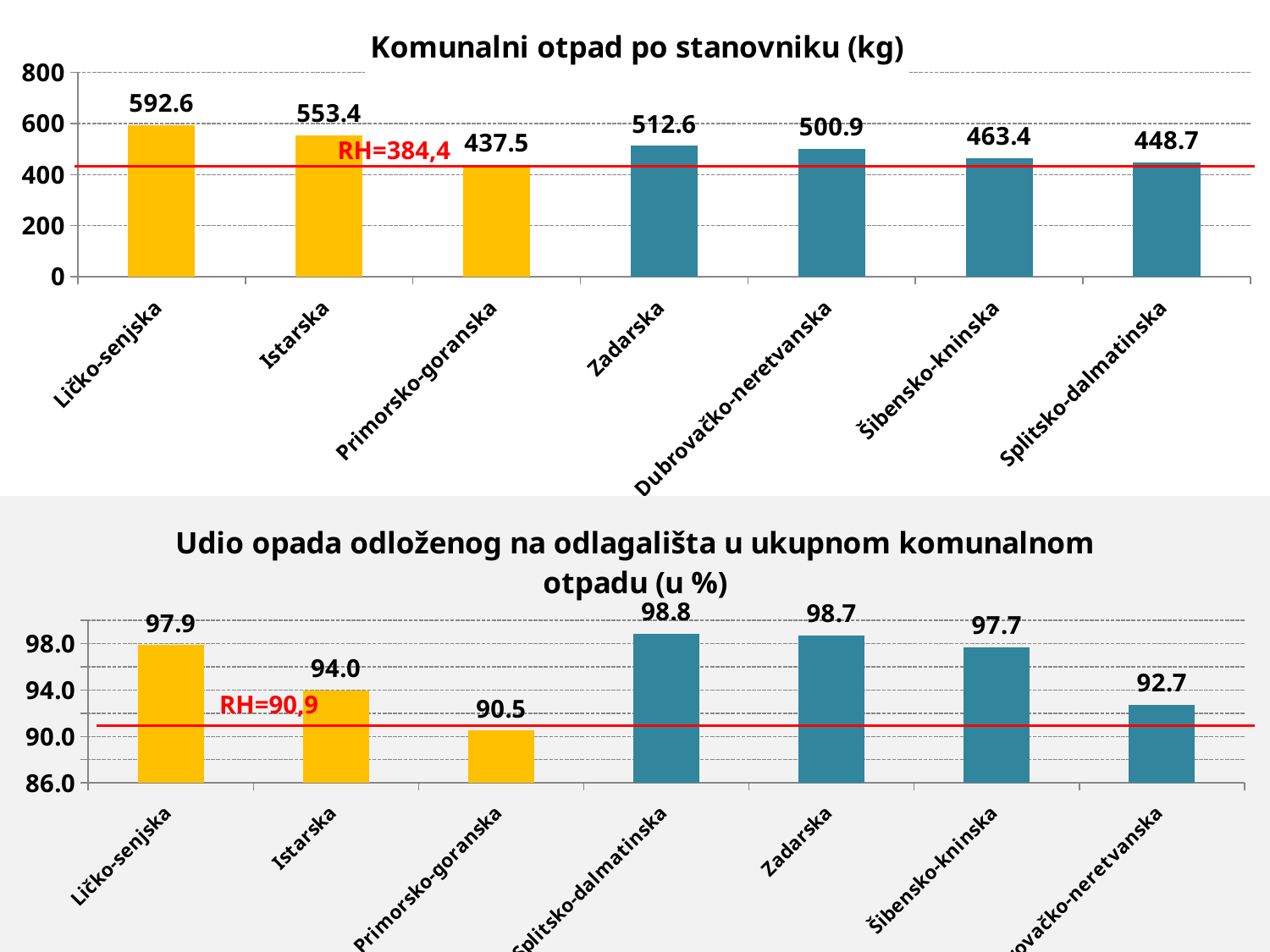
In the chart 'Komunalni otpad po stanovniku (kg)', which county has the lowest value? Primorsko-goranska In the bottom chart 'Udio opada odloženog na odlagališta u ukupnom komunalnom otpadu (u %)', what is the value for Istarska? 94.0 In the bottom chart 'Udio opada odloženog na odlagališta u ukupnom komunalnom otpadu (u %)', what is the difference between Ličko-senjska and Primorsko-goranska? 7.4 In the chart 'Komunalni otpad po stanovniku (kg)', what is the value for Ličko-senjska? 592.6 In the chart 'Komunalni otpad po stanovniku (kg)', what is the difference between Istarska and Zadarska? 40.8 In the chart 'Komunalni otpad po stanovniku (kg)', which is larger, Šibensko-kninska or Splitsko-dalmatinska? Šibensko-kninska What type of chart is the bottom chart on the slide? Bar chart In the chart 'Komunalni otpad po stanovniku (kg)', which county has the highest value? Ličko-senjska In the bottom chart 'Udio opada odloženog na odlagališta u ukupnom komunalnom otpadu (u %)', which county has the lowest value? Primorsko-goranska In the chart 'Komunalni otpad po stanovniku (kg)', how many counties are shown? 7 In the bottom chart 'Udio opada odloženog na odlagališta u ukupnom komunalnom otpadu (u %)', which county has the highest value? Splitsko-dalmatinska In the chart 'Komunalni otpad po stanovniku (kg)', what value is the red reference line labelled with? RH=384,4